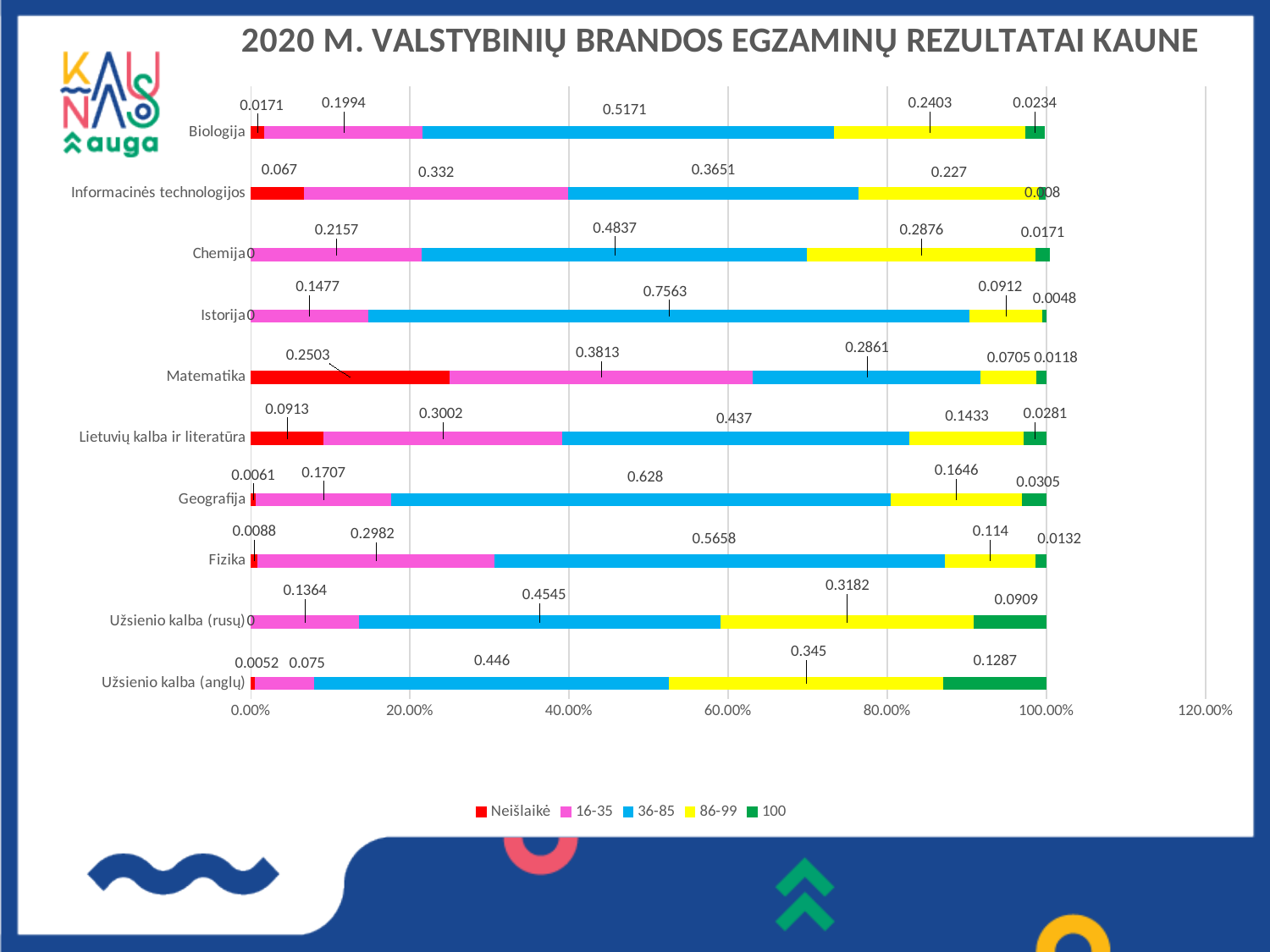
What is the difference between the 36-85 value for Istorija and the 36-85 value for Biologija? 0.2392 Which subject has the highest value for the 100 series? Užsienio kalba (anglų) What is the value of the 86-99 series for Užsienio kalba (rusų)? 0.3182 Which subject has the highest value for the 36-85 series? Istorija How many series does the legend list? 5 Which is larger, the 36-85 value for Fizika or the 36-85 value for Biologija? Fizika How many subjects are shown on the chart? 10 What is the value of the 36-85 series for Istorija? 0.7563 Which subject has the highest value for the Neišlaikė series? Matematika What is the value of the Neišlaikė series for Matematika? 0.2503 What kind of chart is shown on the slide? Stacked bar chart What is the value of the 100 series for Užsienio kalba (anglų)? 0.1287